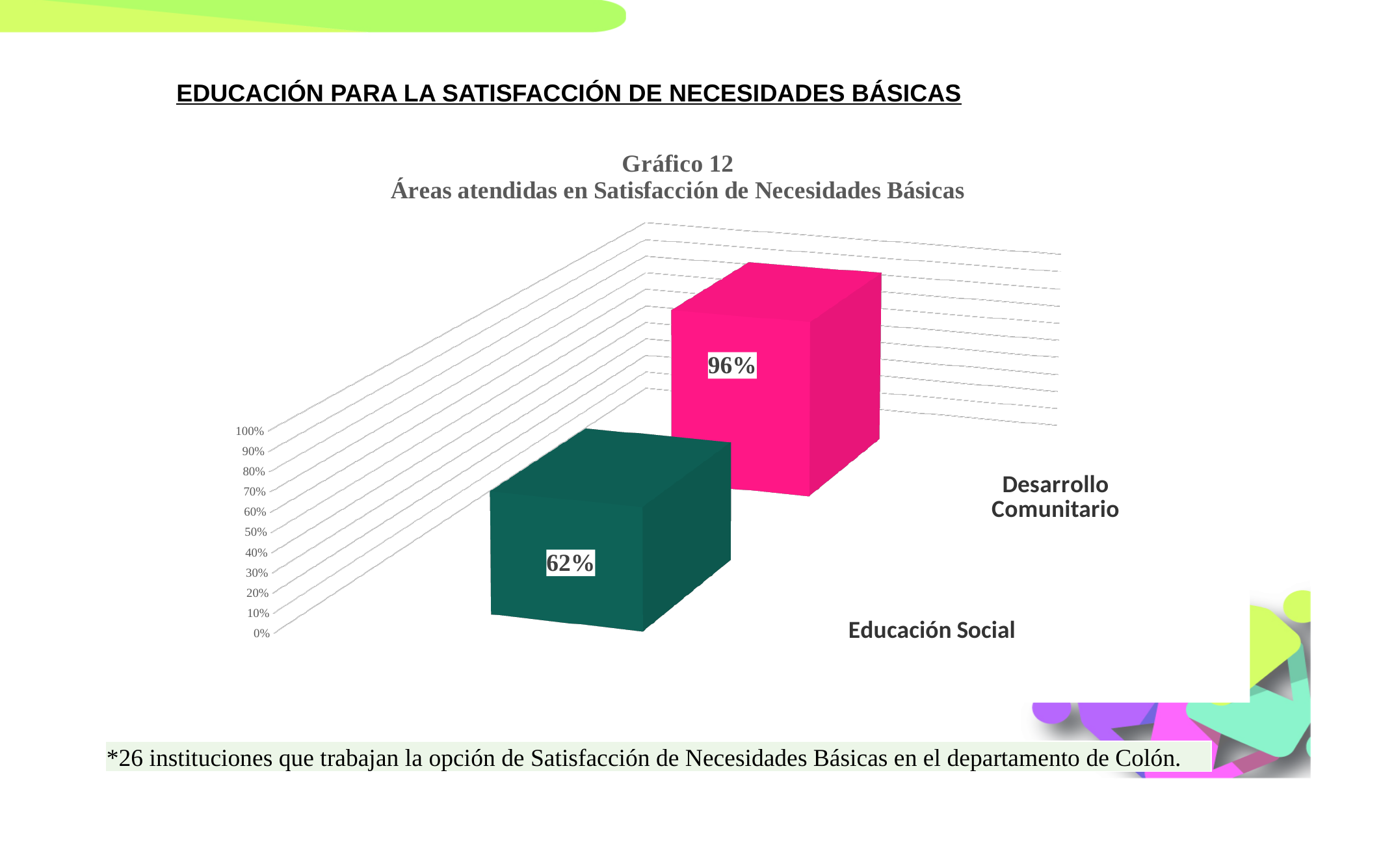
What is the value for Educación Social? 62% Which category has the lowest value? Educación Social Which is larger, the value for Educación Social or the value for Desarrollo Comunitario? Desarrollo Comunitario What is the difference between the values for Desarrollo Comunitario and Educación Social? 34% What is the title of the chart? Gráfico 12 Áreas atendidas en Satisfacción de Necesidades Básicas How many categories are shown in the chart? 2 What is the value for Desarrollo Comunitario? 96% What colour is the bar for Desarrollo Comunitario? Pink Is the value for Desarrollo Comunitario greater or less than 90%? greater Which category has the highest value? Desarrollo Comunitario Is the value for Educación Social greater or less than 50%? greater What kind of chart is shown on the slide? Bar chart